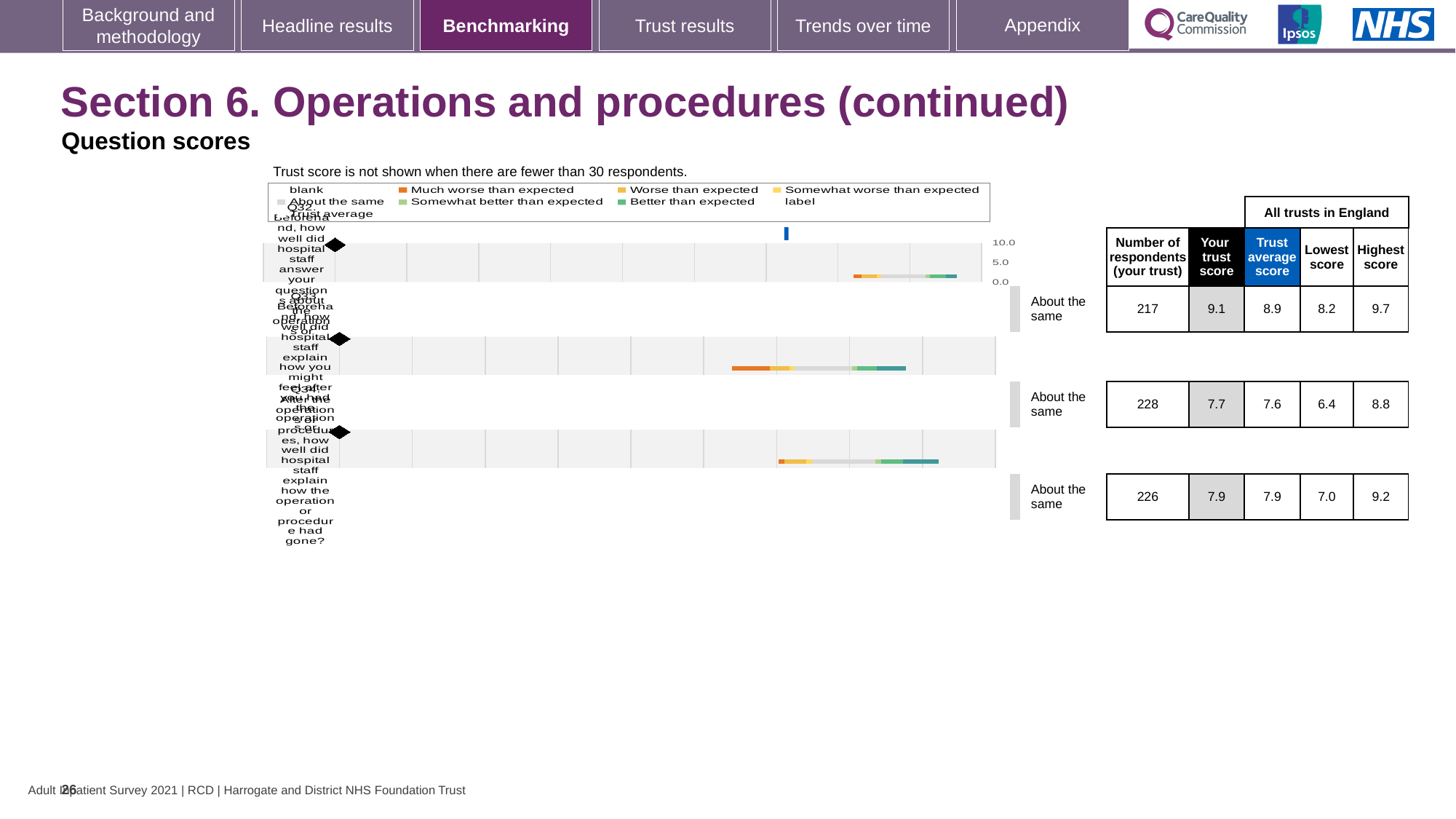
What benchmark category is shown next to each of the three charts? About the same How many question charts (Q32, Q33, Q34) are shown on the slide? 3 Which of the three questions (Q32, Q33, Q34) has the lowest number of respondents? Q32 According to the note above the charts, when is a trust score not shown? When there are fewer than 30 respondents For the Q32 chart (top), what is the 'Your trust score' value shown in the table? 9.1 For the Q33 chart (middle), what is the difference between the highest score and the lowest score? 2.4 What kind of chart is used for the Q32, Q33 and Q34 question scores? Bar chart Which of the three questions (Q32, Q33, Q34) has the highest 'Your trust score'? Q32 For the Q34 chart (bottom), what is the highest score across all trusts in England? 9.2 For the Q33 chart (middle), how many respondents does the table show for your trust? 228 For the Q32 chart (top), which is larger: your trust score or the trust average score? Your trust score (9.1)